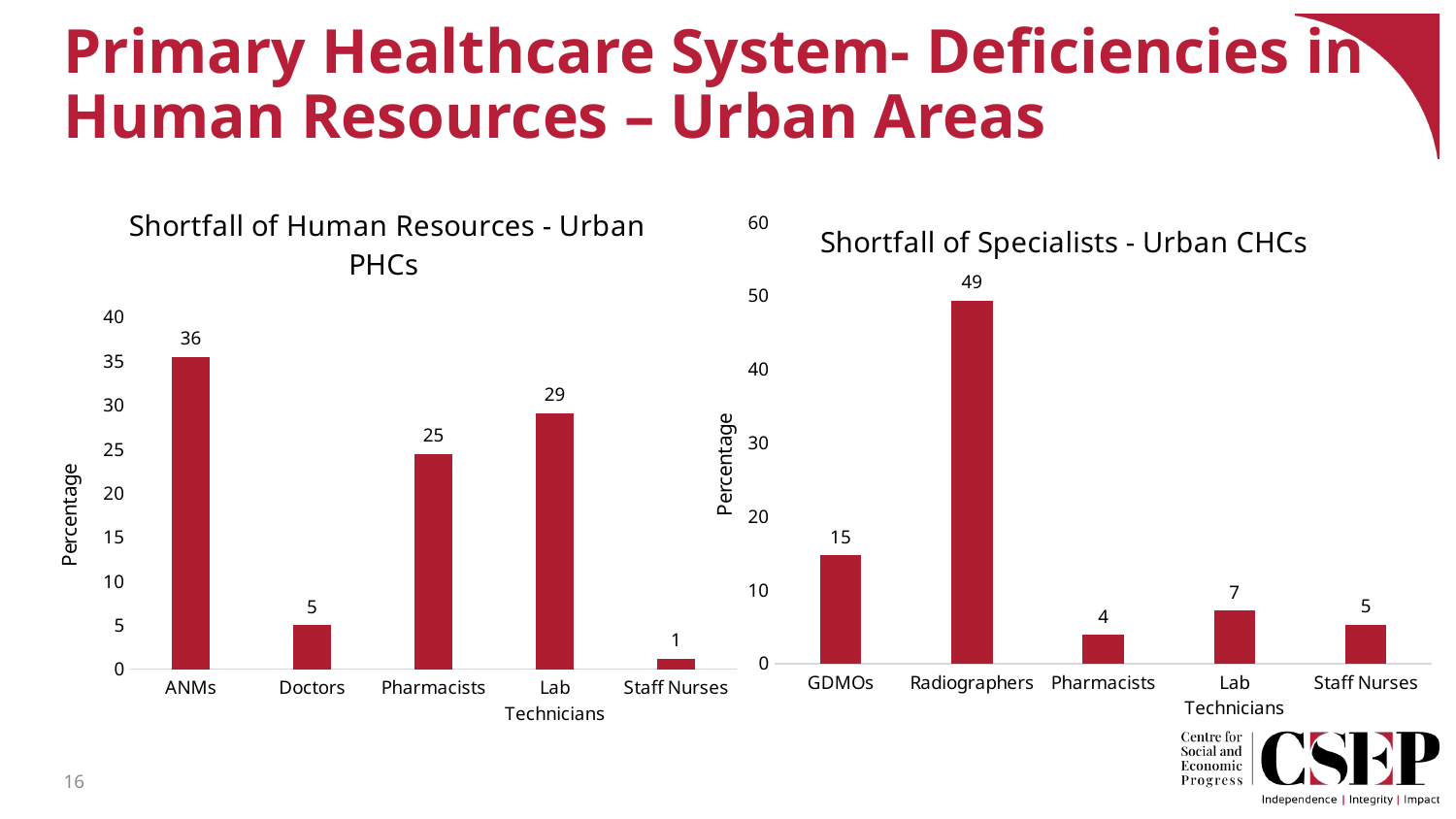
In the 'Shortfall of Human Resources - Urban PHCs' chart, what is the difference between the values for ANMs and Pharmacists? 11 In the 'Shortfall of Human Resources - Urban PHCs' chart, what is the value for ANMs? 36 In the 'Shortfall of Human Resources - Urban PHCs' chart, what is the value for Lab Technicians? 29 In the 'Shortfall of Human Resources - Urban PHCs' chart, how many categories are shown on the x axis? 5 In the 'Shortfall of Specialists - Urban CHCs' chart, which is larger, the value for Lab Technicians or the value for Staff Nurses? Lab Technicians What kind of chart is the 'Shortfall of Specialists - Urban CHCs' chart? Bar chart In the 'Shortfall of Specialists - Urban CHCs' chart, what is the difference between the values for Radiographers and GDMOs? 34 In the 'Shortfall of Human Resources - Urban PHCs' chart, which category has the highest value? ANMs In the 'Shortfall of Human Resources - Urban PHCs' chart, which category has the lowest value? Staff Nurses In the 'Shortfall of Specialists - Urban CHCs' chart, what is the value for Radiographers? 49 In the 'Shortfall of Specialists - Urban CHCs' chart, what is the value for GDMOs? 15 In the 'Shortfall of Specialists - Urban CHCs' chart, which category has the lowest value? Pharmacists